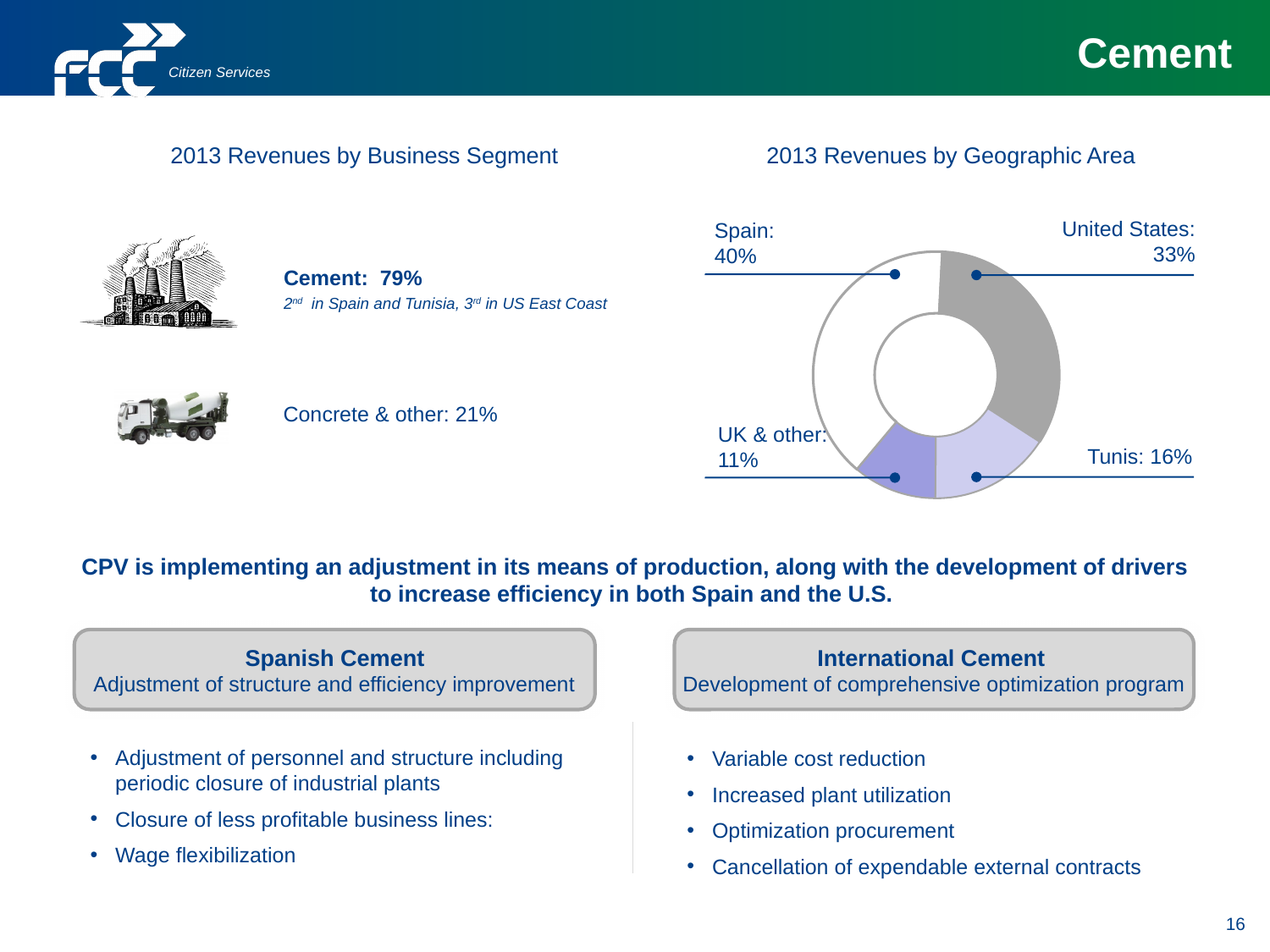
What share of 2013 revenues by geographic area comes from UK & other? 11% What kind of chart is used to show 2013 Revenues by Geographic Area? Pie chart (donut) What share of 2013 revenues by geographic area comes from the United States? 33% What is the title of the chart on the right side of the slide? 2013 Revenues by Geographic Area What is the difference in percentage points between Spain's and the United States' shares of 2013 revenues? 7 How many geographic areas are shown in the 2013 Revenues by Geographic Area chart? 4 Which has a larger share of 2013 revenues by geographic area, Tunis or UK & other? Tunis What share of 2013 revenues by geographic area comes from Spain? 40% Which geographic area has the largest share of 2013 revenues in the chart? Spain What share of 2013 revenues by geographic area comes from Tunis? 16% Which geographic area has the smallest share of 2013 revenues in the chart? UK & other What is the combined share of 2013 revenues from Spain and Tunis? 56%